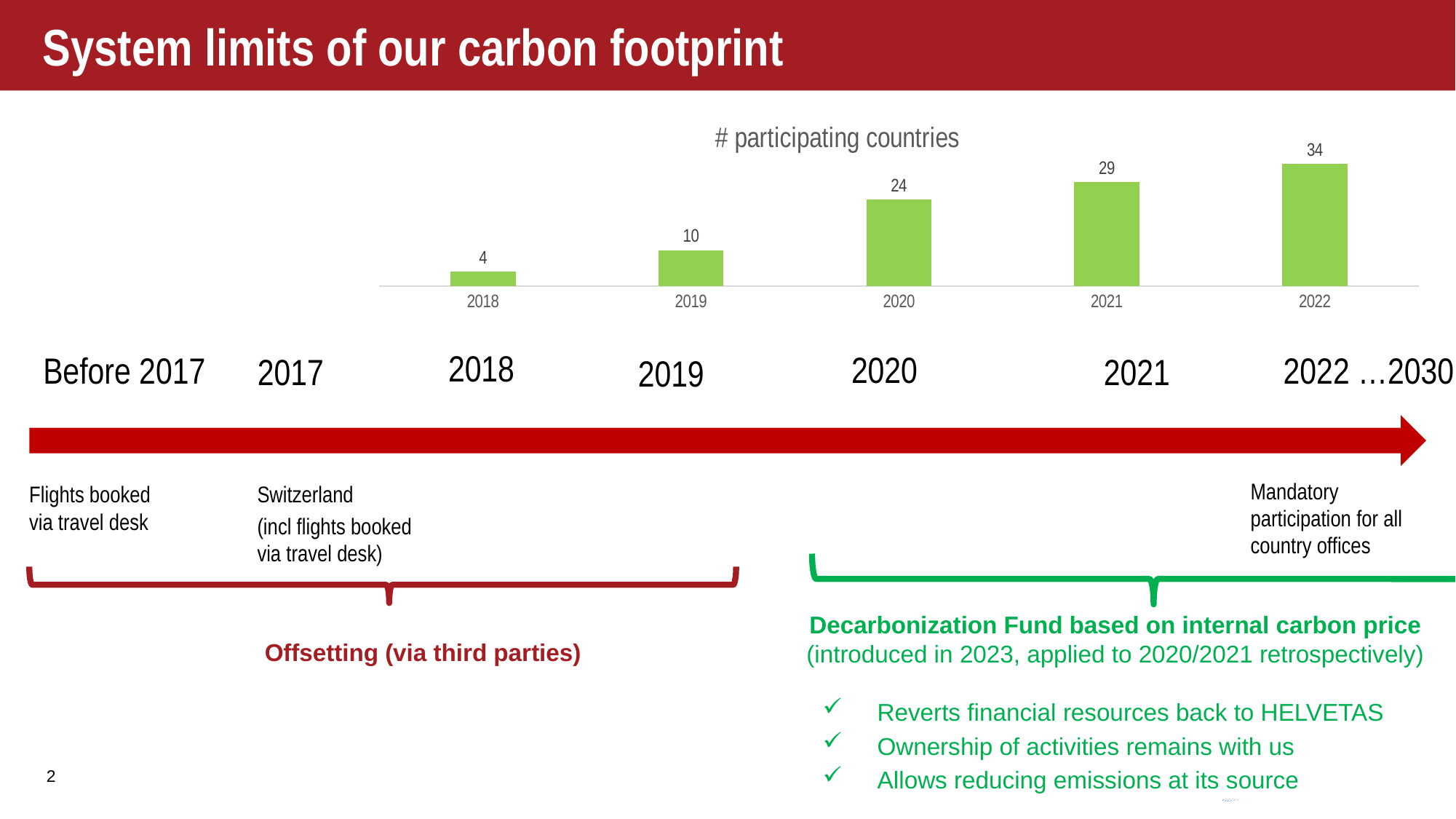
By how much did the number of participating countries increase from 2019 to 2020? 14 Does the number of participating countries rise or fall from 2018 to 2022? Rise Which year has the highest number of participating countries? 2022 What is the number of participating countries in 2020? 24 How many years are shown on the x axis of the chart? 5 What kind of chart is used to show the number of participating countries? Bar chart What is the difference in participating countries between 2022 and 2021? 5 What is the number of participating countries in 2022? 34 What is the number of participating countries in 2018? 4 What is the title of the chart? # participating countries Which year has more participating countries, 2019 or 2021? 2021 Which year has the lowest number of participating countries? 2018